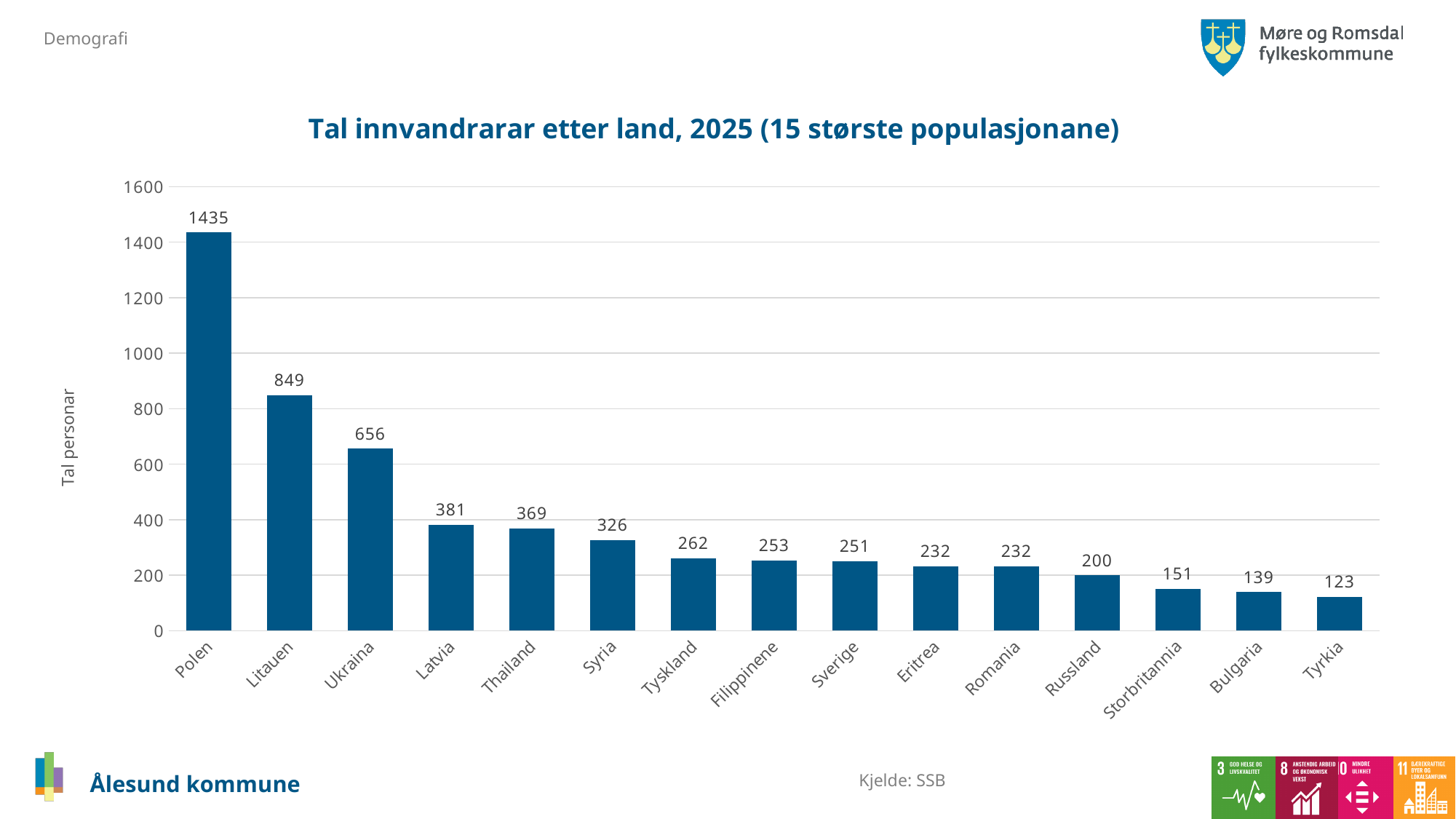
What is the difference between the values for Latvia and Thailand? 12 Is the value for Litauen greater or less than 800? greater What is the difference between the values for Polen and Litauen? 586 What is the value for Ukraina? 656 What is the title of the chart? Tal innvandrarar etter land, 2025 (15 største populasjonane) How many countries are shown on the x axis? 15 What kind of chart is this? bar chart Which country has the highest value? Polen Which is larger, the value for Syria or the value for Tyskland? Syria Which country has the lowest value? Tyrkia What is the value for Storbritannia? 151 What is the value for Polen? 1435